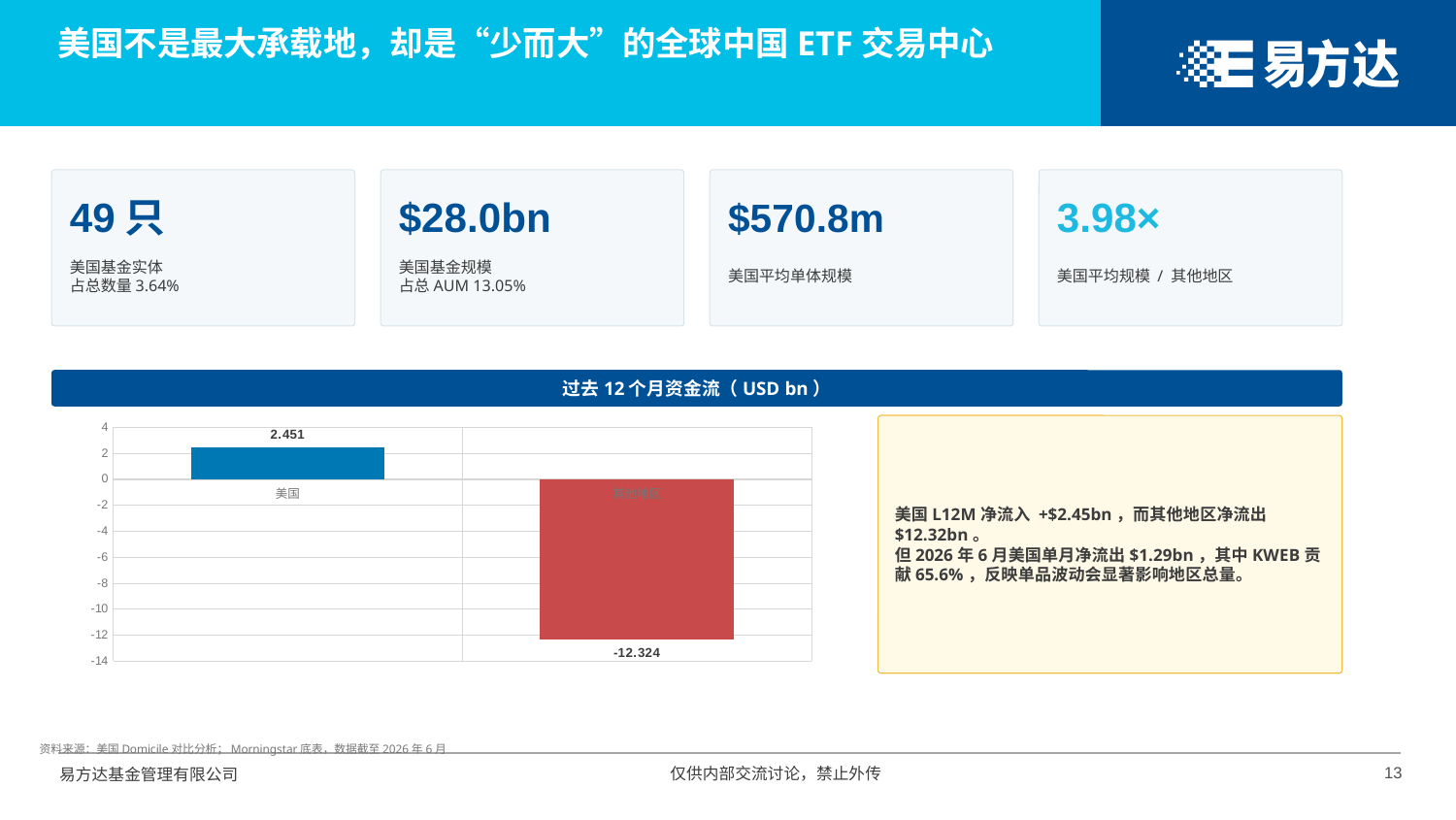
In the chart 过去 12 个月资金流（USD bn）, is the value of the red bar greater or less than -10? less In the chart 过去 12 个月资金流（USD bn）, which category has the highest value? 美国 In the chart 过去 12 个月资金流（USD bn）, which is larger: the value for 美国 or the value of the red bar? 美国 What is the title of the bar chart on the slide? 过去 12 个月资金流（USD bn） In the chart 过去 12 个月资金流（USD bn）, is the value for 美国 greater or less than 2? greater In the chart 过去 12 个月资金流（USD bn）, what is the difference between the value for 美国 and the value of the red bar? 14.775 What kind of chart is 过去 12 个月资金流（USD bn）? bar chart In the chart 过去 12 个月资金流（USD bn）, what is the value for 美国? 2.451 In the chart 过去 12 个月资金流（USD bn）, what colour is the bar for 美国? blue How many bars are plotted in the chart 过去 12 个月资金流（USD bn）? 2 In the chart 过去 12 个月资金流（USD bn）, what is the value shown for the red bar? -12.324 In the chart 过去 12 个月资金流（USD bn）, is the value for 美国 greater or less than 4? less